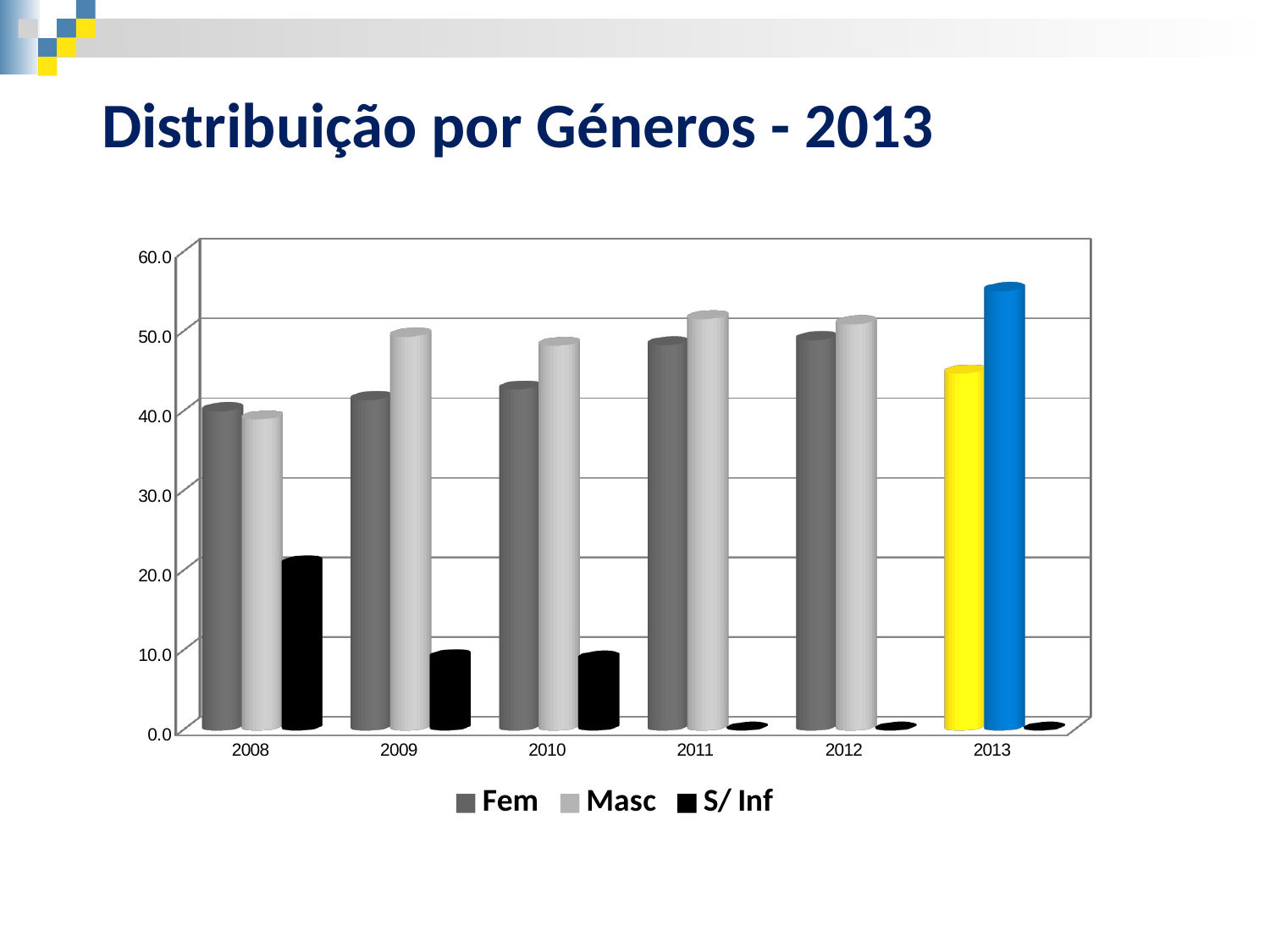
Is the Fem value for 2008 greater or less than 50.0? less How many years are shown on the x axis? 6 In which year is the Masc value highest? 2013 What kind of chart is shown on the slide? Bar chart In which year is the S/ Inf value highest? 2008 Do the S/ Inf values rise or fall from 2008 to 2013? fall How many series does the legend list? 3 What is the title of the chart? Distribuição por Géneros - 2013 Is the Masc value for 2013 greater or less than 50.0? greater In 2008, which is larger, Fem or S/ Inf? Fem Is the S/ Inf value for 2008 greater or less than 10.0? greater In 2009, which is larger, Fem or Masc? Masc